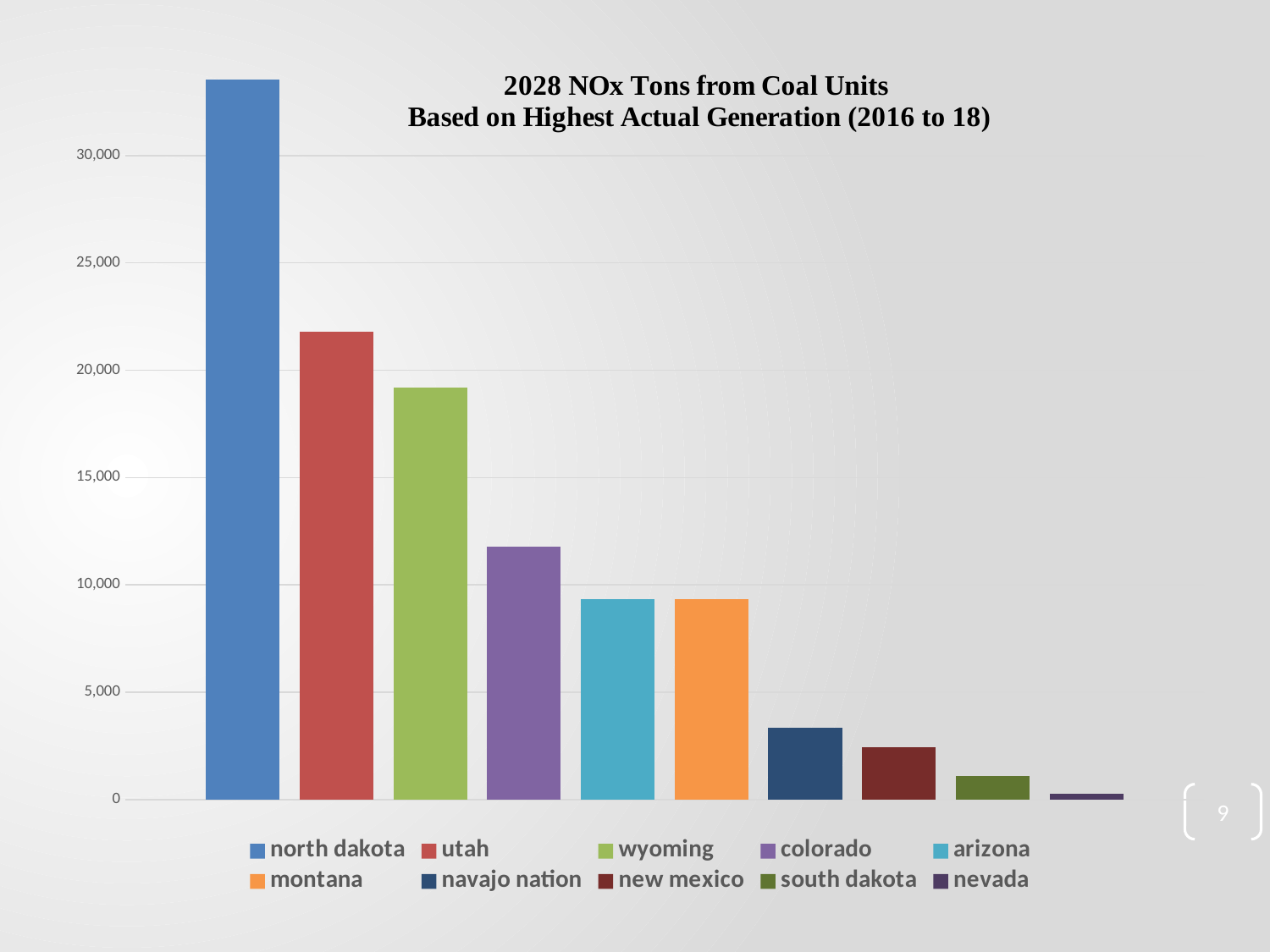
Is the value for navajo nation greater or less than 5,000? less What is the title of the chart? 2028 NOx Tons from Coal Units Based on Highest Actual Generation (2016 to 18) How many bars are plotted in the chart? 10 Is the value for north dakota greater or less than 30,000? greater Is the value for wyoming greater or less than 20,000? less What kind of chart is shown on the slide? bar chart Which has the larger value, utah or wyoming? utah Which state or nation has the lowest 2028 NOx tons from coal units? nevada Which state or nation has the highest 2028 NOx tons from coal units? north dakota Which has the larger value, colorado or navajo nation? colorado